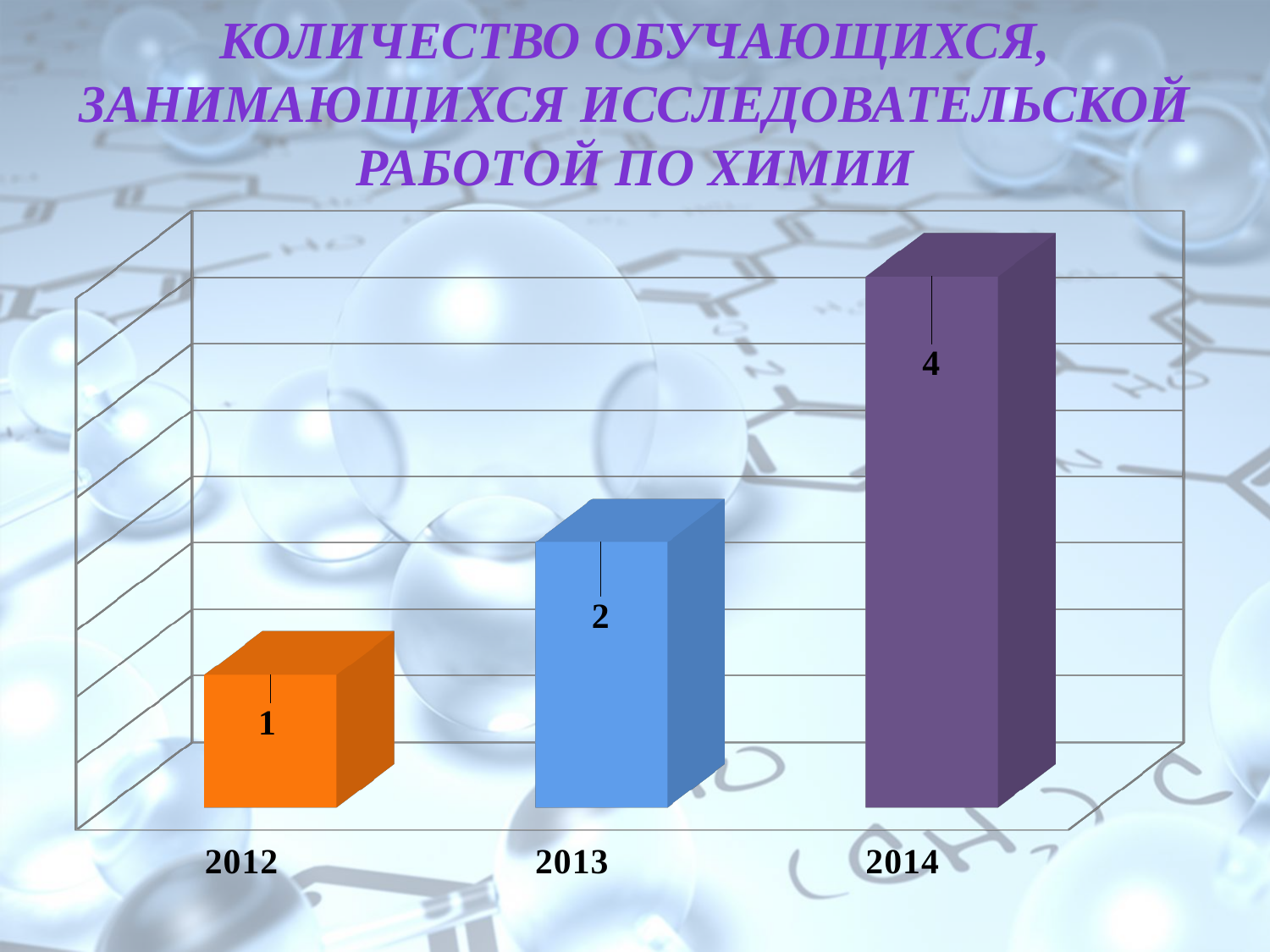
What is the value for 2013? 2 What colour is the bar for 2014? purple Which year has the highest value? 2014 What is the difference between the values for 2013 and 2012? 1 Which year has the lowest value? 2012 Do the values rise or fall from 2012 to 2014? rise What is the value for 2012? 1 How many years are shown on the x axis? 3 What is the value for 2014? 4 What is the difference between the values for 2014 and 2012? 3 What kind of chart is this? bar chart Which is larger, the value for 2013 or the value for 2014? 2014